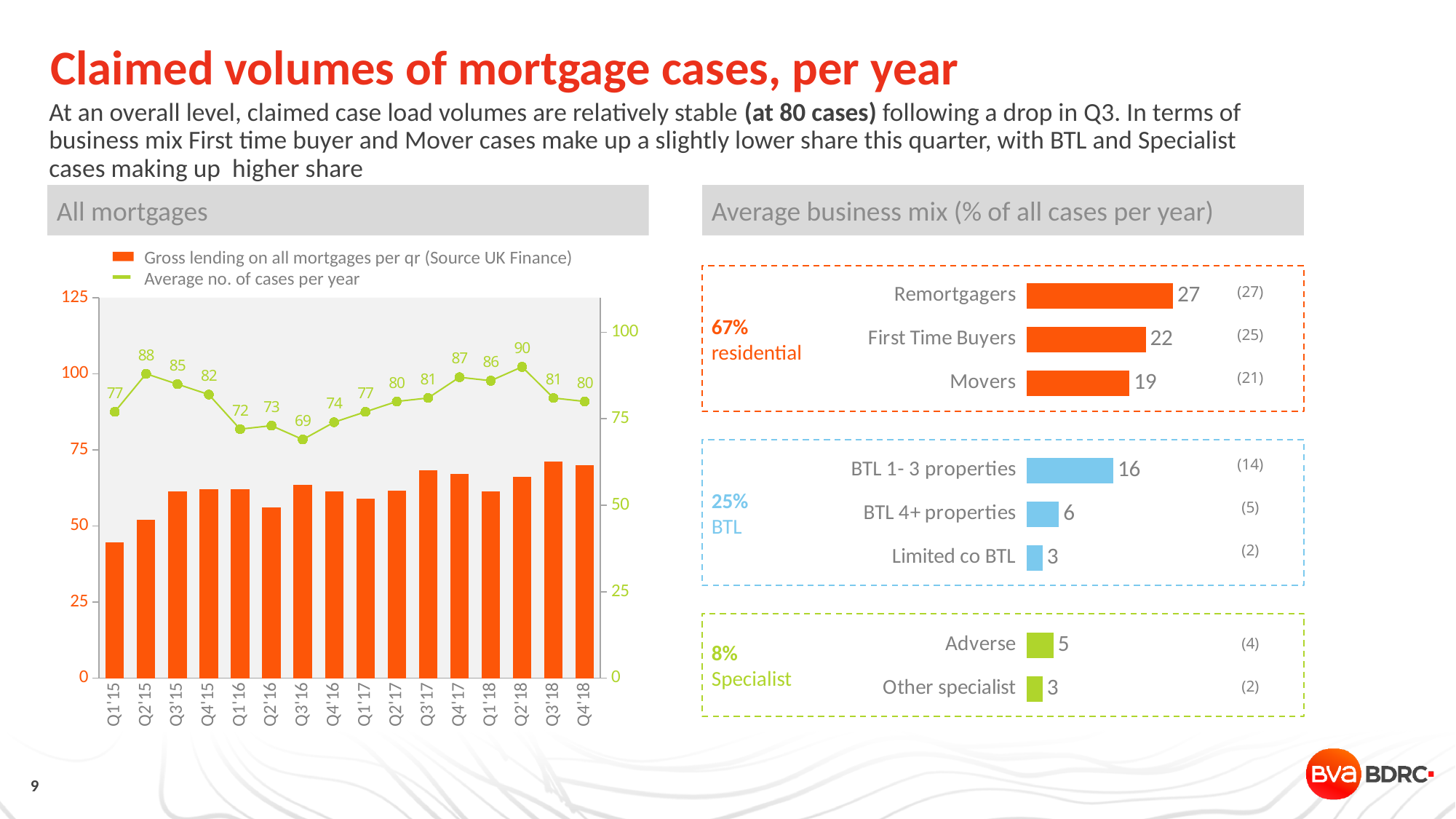
In the All mortgages chart, what is the average number of cases per year for Q2'18? 90 What kind of chart is the Average business mix chart? bar chart In the Average business mix chart, which category has the highest value? Remortgagers In the All mortgages chart, what is the difference between the average number of cases per year in Q2'18 and Q3'16? 21 In the All mortgages chart, which quarter has the lowest average number of cases per year? Q3'16 In the All mortgages chart, is the gross lending bar for Q1'15 greater or less than 50? less In the Average business mix chart, which is larger: BTL 1- 3 properties or BTL 4+ properties? BTL 1- 3 properties In the Average business mix chart, what is the value for Remortgagers? 27 In the All mortgages chart, how many series does the legend list? 2 In the Average business mix chart, what is the difference between First Time Buyers and Movers? 3 In the All mortgages chart, which quarter has the highest average number of cases per year? Q2'18 In the All mortgages chart, how many quarters are shown on the x axis? 16